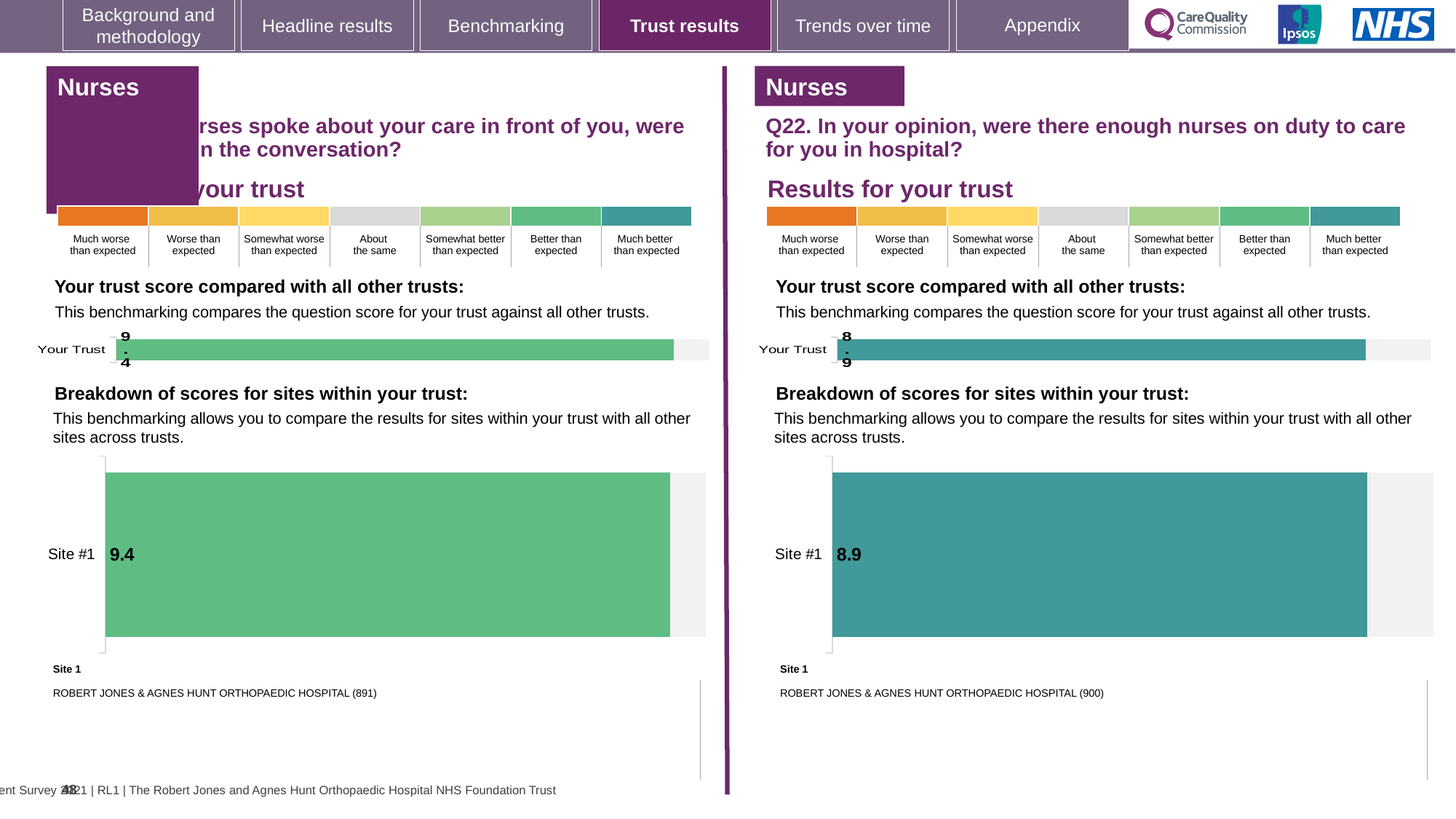
In the Q22 section on the right-hand side of the slide, what is the score shown for Site #1? 8.9 What kind of chart is used to show the Site #1 score in the Q22 section on the right-hand side of the slide? Bar chart How many sites are shown in the breakdown of scores chart in the Q22 section on the right-hand side of the slide? 1 How many sites are shown in the breakdown of scores chart on the left-hand side of the slide? 1 On the left-hand side of the slide, which benchmarking category does the colour of the Your Trust bar correspond to? Better than expected What is the difference between the Site #1 score on the left-hand side of the slide and the Site #1 score in the Q22 section on the right? 0.5 On the left-hand side of the slide, what is the score shown for Your Trust? 9.4 Is the Site #1 score on the left-hand side of the slide greater or less than the Site #1 score in the Q22 section on the right? greater In the Q22 section on the right-hand side of the slide, what is the score shown for Your Trust? 8.9 On the left-hand side of the slide, what is the score shown for Site #1? 9.4 Which is larger: the Your Trust score on the left-hand side of the slide or the Your Trust score in the Q22 section on the right? The left-hand side (9.4) In the Q22 section on the right-hand side of the slide, which benchmarking category does the colour of the Your Trust bar correspond to? Much better than expected